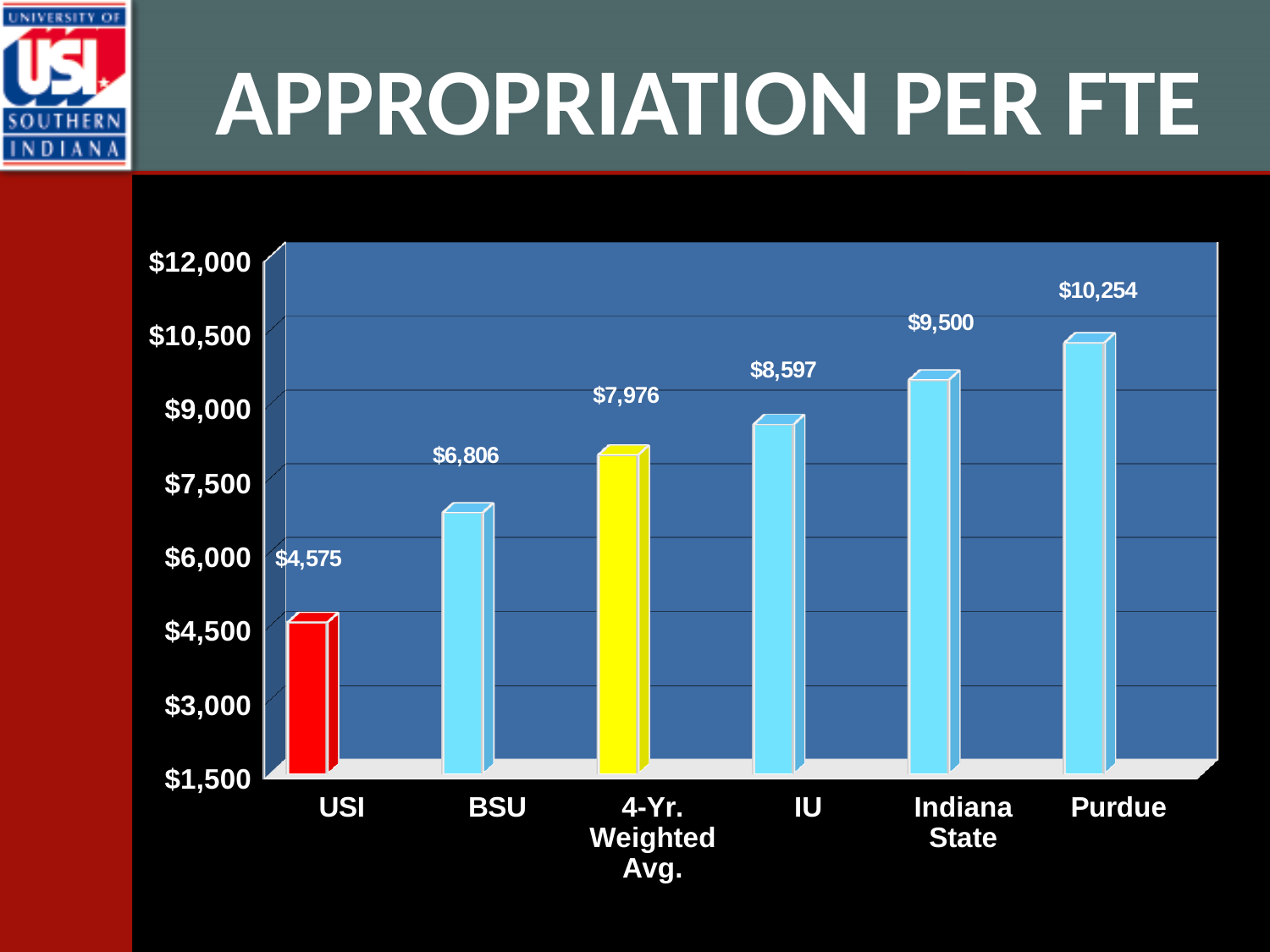
What is the value shown for the 4-Yr. Weighted Avg.? $7,976 Is the value for Indiana State greater or less than $9,000? greater How many categories are shown on the x axis? 6 What kind of chart is shown on the slide? bar chart Which bar is coloured yellow? 4-Yr. Weighted Avg. What is the appropriation per FTE for Indiana State? $9,500 What is the difference between IU's value and BSU's value? $1,791 Which institution has the lowest appropriation per FTE? USI Which institution has the highest appropriation per FTE? Purdue What is the difference between Purdue's and USI's appropriation per FTE? $5,679 What is the appropriation per FTE for USI? $4,575 Which is larger, the value for BSU or the value for IU? IU